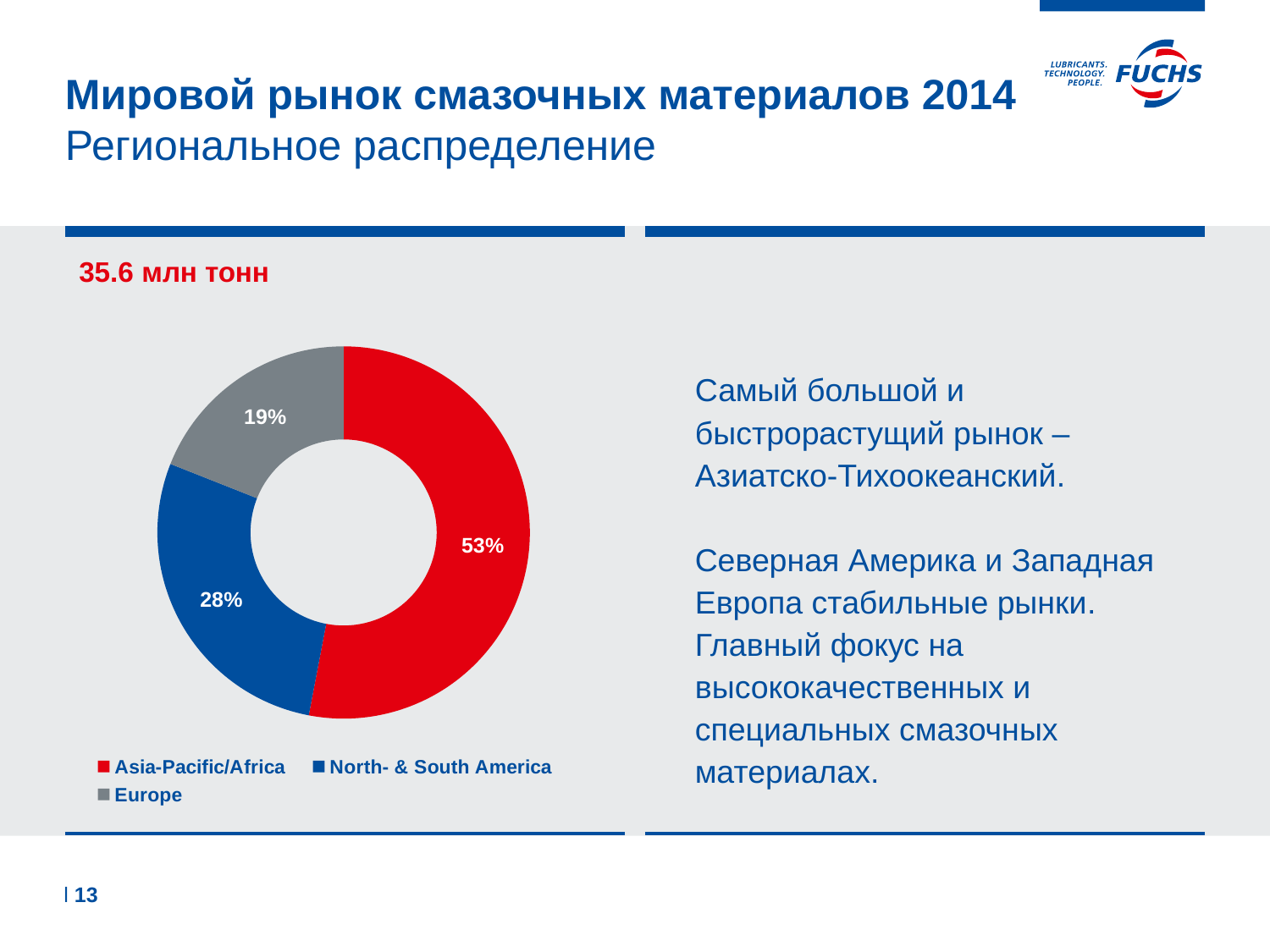
What is the difference in percentage points between the Asia-Pacific/Africa share and the Europe share? 34 What share of the world lubricants market does Asia-Pacific/Africa hold? 53% What share of the world lubricants market does North- & South America hold? 28% Which region has the smallest share of the world lubricants market? Europe What kind of chart is shown on the slide? Pie chart (doughnut) What share of the world lubricants market does Europe hold? 19% Which has a larger share, North- & South America or Europe? North- & South America What total market volume is stated above the chart? 35.6 млн тонн Which region has the largest share of the world lubricants market? Asia-Pacific/Africa How many regions are shown in the chart? 3 Which colour represents Europe in the chart? Grey What is the difference in percentage points between the North- & South America share and the Europe share? 9